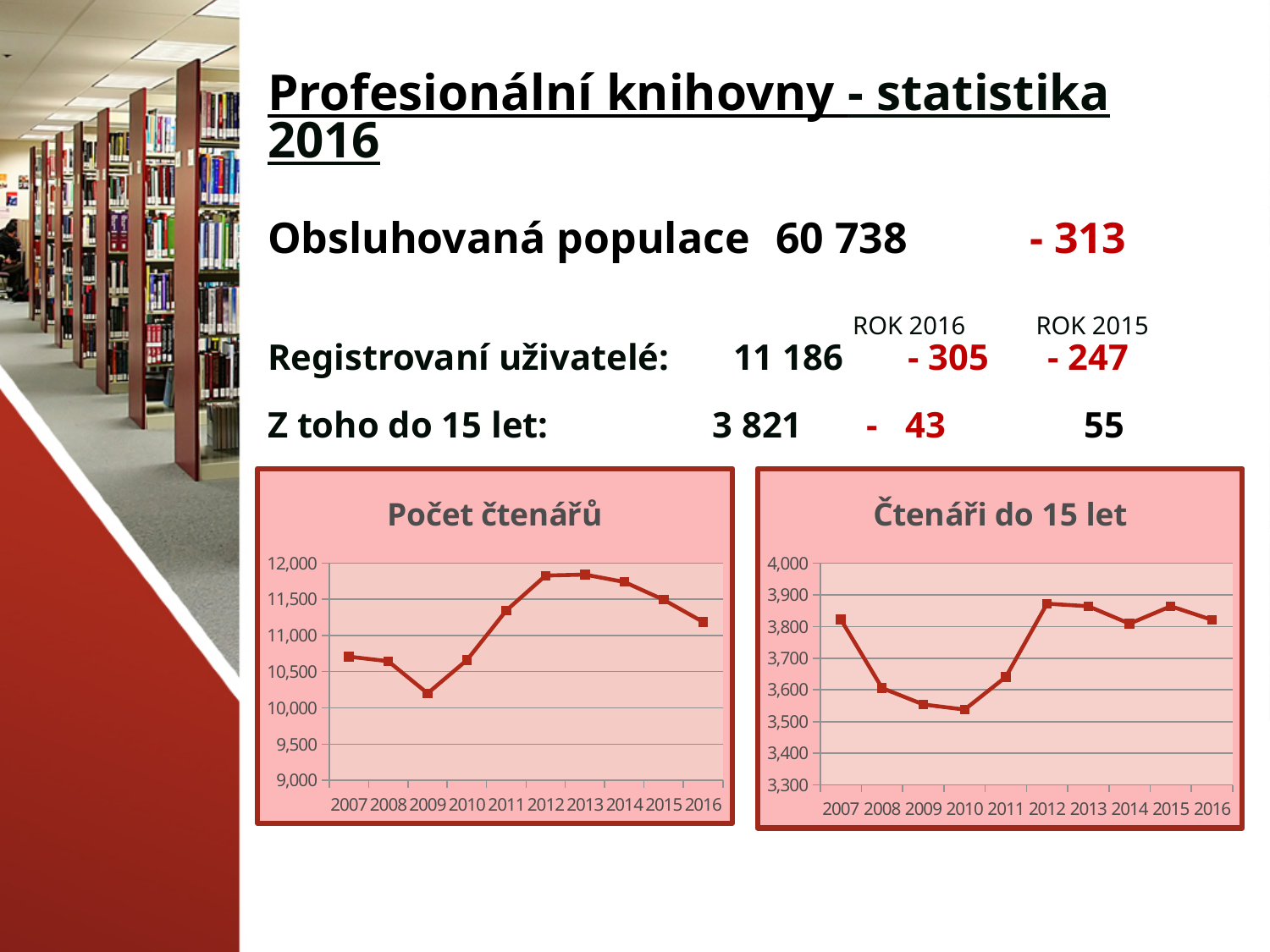
In the "Počet čtenářů" chart, which year has the lowest value? 2009 How many data points are plotted in the "Čtenáři do 15 let" chart? 10 In the "Počet čtenářů" chart, do the values rise or fall from 2013 to 2016? fall In the "Čtenáři do 15 let" chart, is the value for 2010 greater or less than 3,600? less How many years are plotted on the x axis of the "Počet čtenářů" chart? 10 In the "Čtenáři do 15 let" chart, is the value for 2012 greater or less than 3,800? greater In the "Počet čtenářů" chart, is the value for 2016 greater or less than 11,000? greater What kind of chart is the "Počet čtenářů" chart? line chart In the "Počet čtenářů" chart, which is larger, the value for 2012 or the value for 2009? 2012 What is the title of the chart on the right of the slide? Čtenáři do 15 let In the "Čtenáři do 15 let" chart, do the values rise or fall from 2007 to 2010? fall